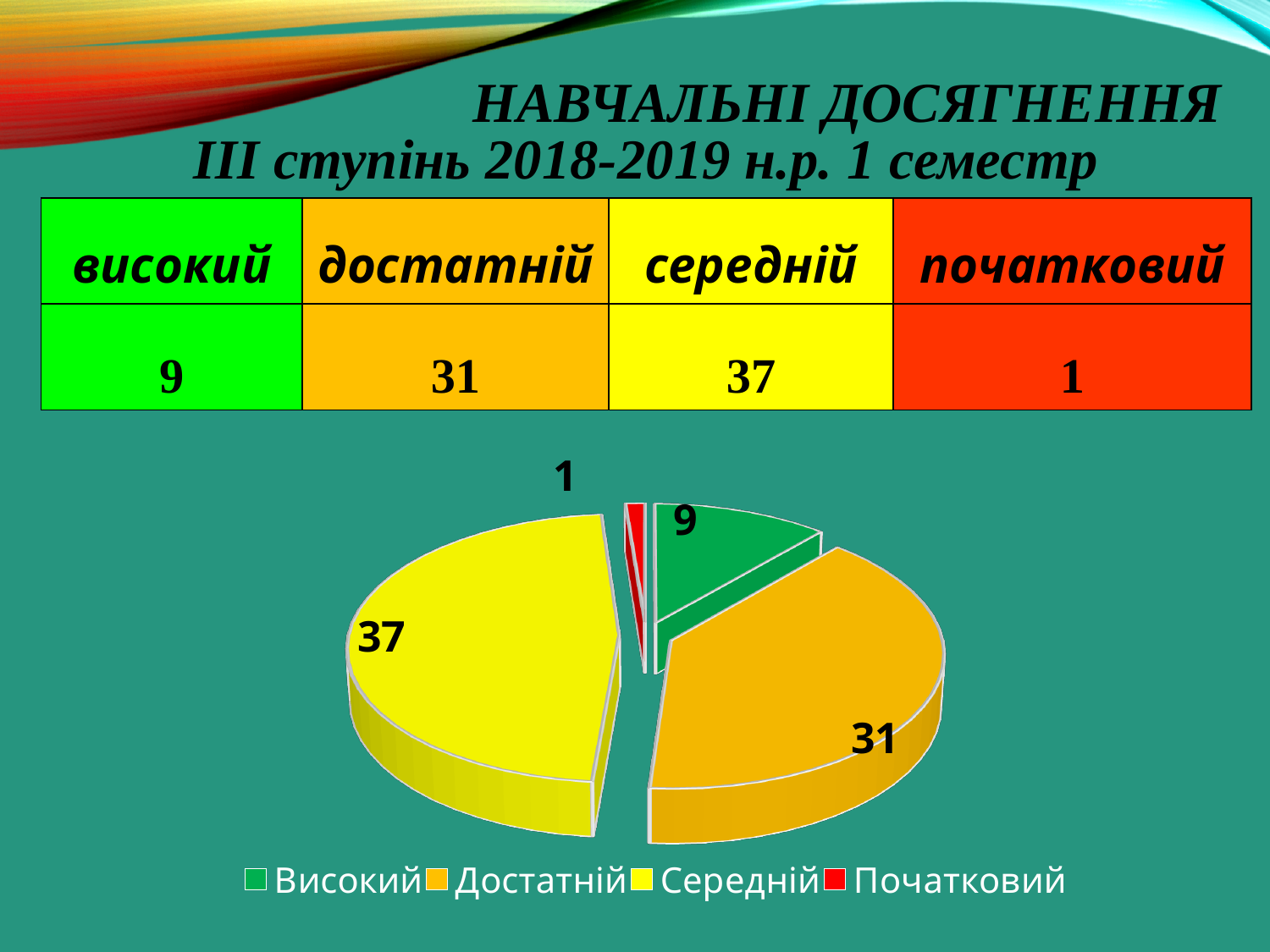
What is the value of the Початковий slice in the pie chart? 1 What is the value of the Середній slice in the pie chart? 37 What is the value of the Достатній slice in the pie chart? 31 Which category has the smallest slice in the pie chart? Початковий What is the total of all slices in the pie chart? 78 Which is larger in the pie chart, Високий or Достатній? Достатній What is the difference between the Середній and Достатній values in the pie chart? 6 Which category has the largest slice in the pie chart? Середній What kind of chart is shown on the slide? pie chart What colour is the Середній slice in the pie chart? yellow How many slices does the pie chart have? 4 What is the value of the Високий slice in the pie chart? 9